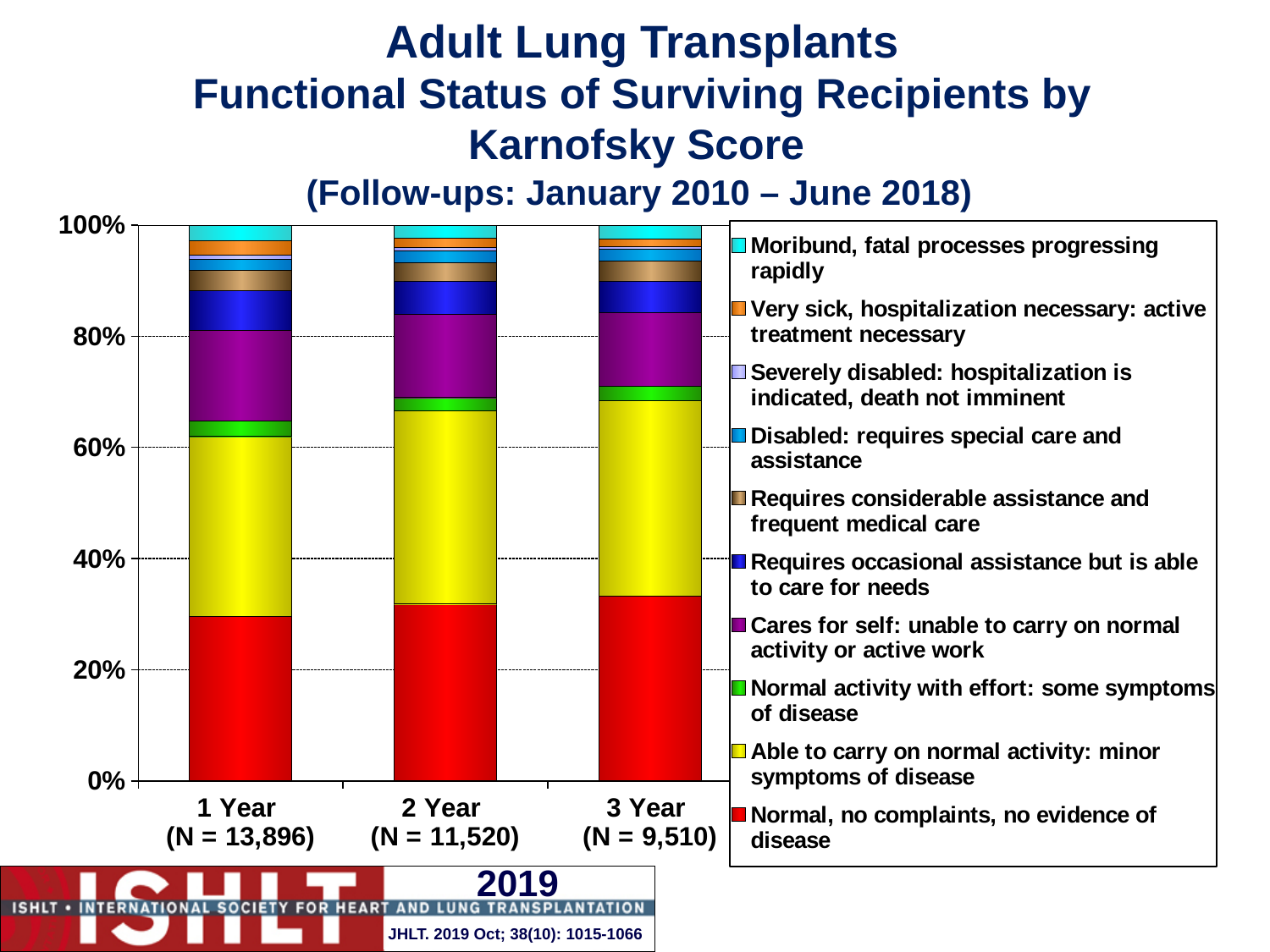
Which colour represents 'Normal, no complaints, no evidence of disease' in the chart? Red What is the N for the 1 Year follow-up group? 13,896 Which category is the smallest segment in the 1 Year bar? Severely disabled: hospitalization is indicated, death not imminent What is the total of the 2 Year stacked bar? 100% Does the share of 'Normal, no complaints, no evidence of disease' recipients rise or fall from 1 Year to 3 Year? rise What is the N for the 3 Year follow-up group? 9,510 Which is larger: the 'Normal, no complaints, no evidence of disease' share at 1 Year or at 3 Year? 3 Year How many Karnofsky score categories does the legend list? 10 Is the share of 'Normal, no complaints, no evidence of disease' recipients at 1 Year greater or less than 40%? less How many follow-up time points (bars) are shown on the x axis? 3 What kind of chart is shown on the slide? Stacked bar chart Is the share of 'Normal, no complaints, no evidence of disease' recipients at 3 Year greater or less than 20%? greater